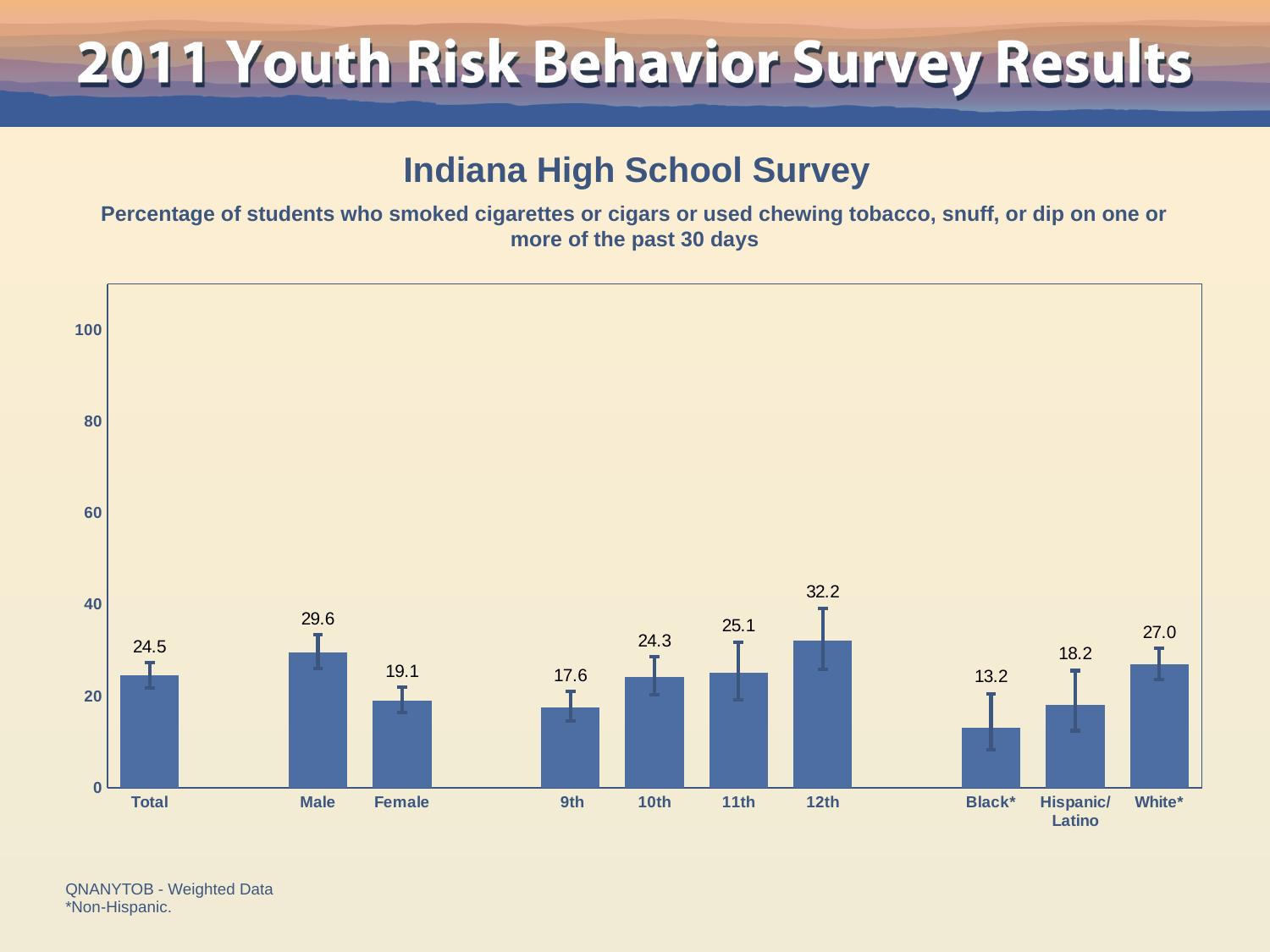
What is the value for Total? 24.5 Which is larger, the value for 9th or the value for 10th? 10th What kind of chart is this? bar chart Is the value for White* greater or less than 20? greater How many categories are shown on the x axis? 10 What is the value for Hispanic/Latino? 18.2 Which category has the highest value? 12th Which category has the lowest value? Black* What is the difference between the Male and Female values? 10.5 Do the values rise or fall from 9th to 12th grade? rise What is the value for Male? 29.6 What is the value for 12th grade? 32.2